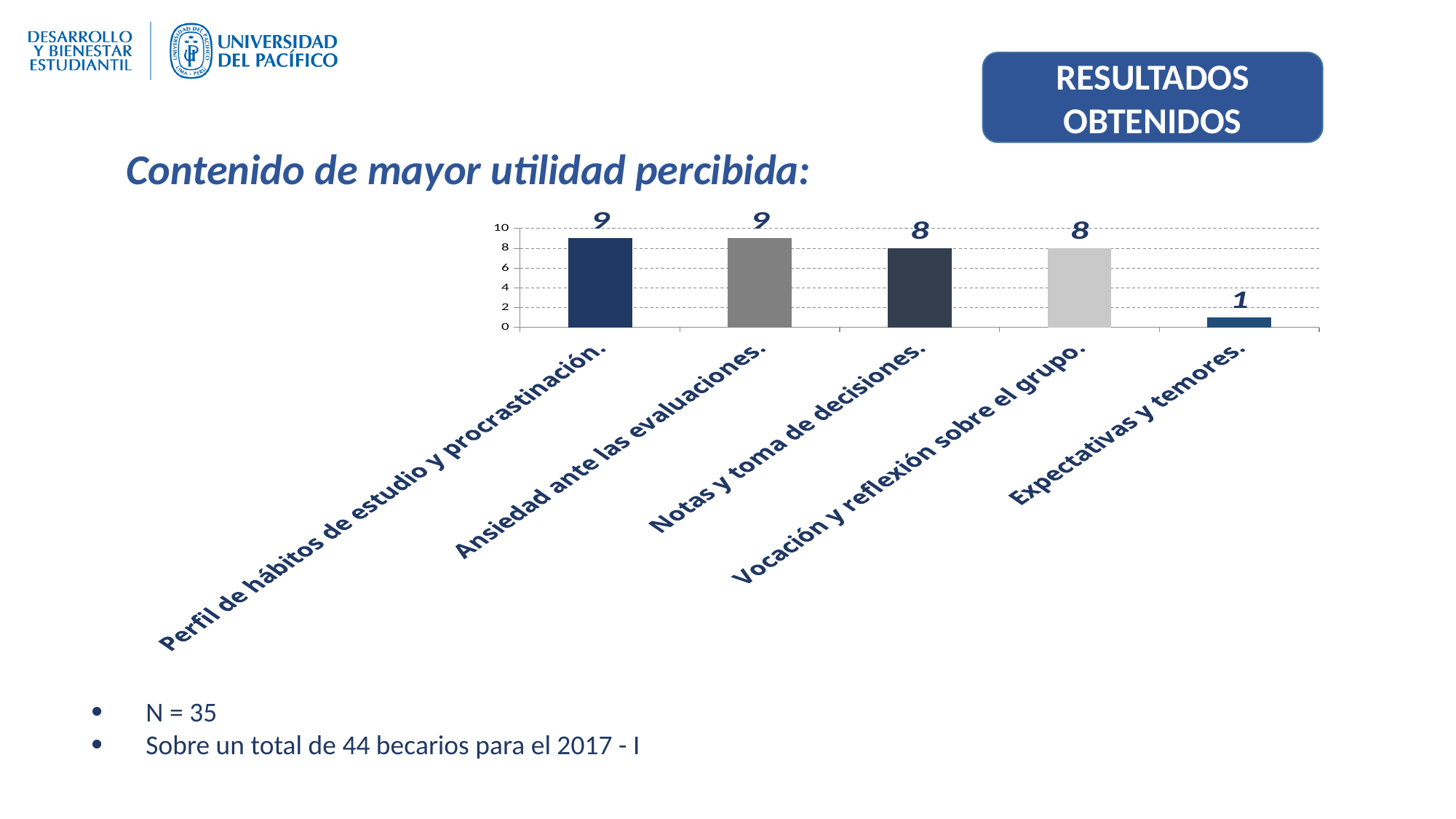
Which category has the lowest value? Expectativas y temores. How many categories are shown in the chart? 5 What is the value for "Expectativas y temores."? 1 What is the value for "Perfil de hábitos de estudio y procrastinación."? 9 What is the heading above the chart? Contenido de mayor utilidad percibida: What is the value for "Vocación y reflexión sobre el grupo."? 8 What is the difference between the values for "Perfil de hábitos de estudio y procrastinación." and "Notas y toma de decisiones."? 1 What is the value for "Ansiedad ante las evaluaciones."? 9 Which is larger, the value for "Vocación y reflexión sobre el grupo." or the value for "Expectativas y temores."? Vocación y reflexión sobre el grupo. What is the difference between the values for "Ansiedad ante las evaluaciones." and "Expectativas y temores."? 8 What kind of chart is shown on the slide? Bar chart What is the value for "Notas y toma de decisiones."? 8